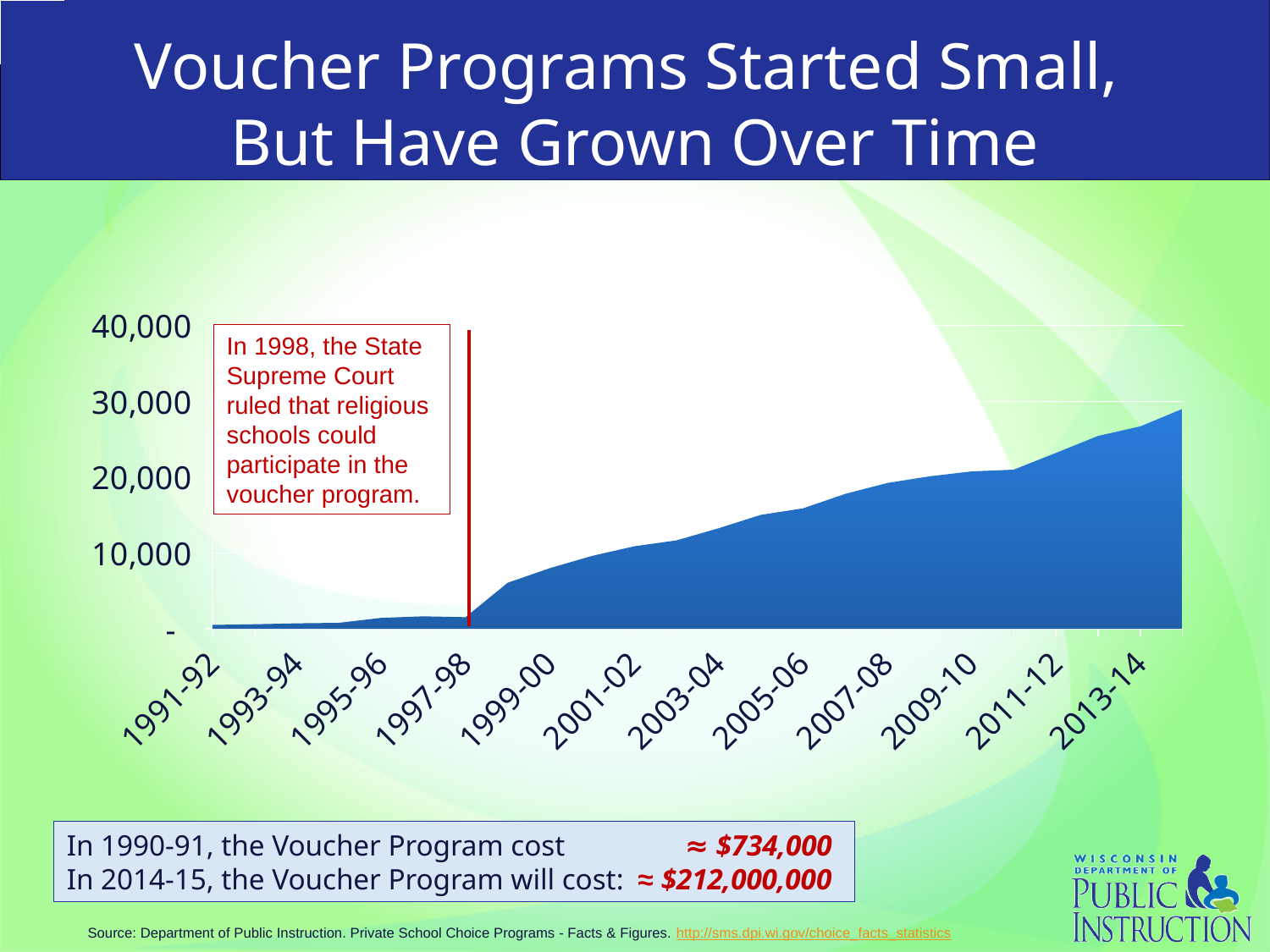
What kind of chart is shown on the slide? Area chart What is the title of the slide containing the chart? Voucher Programs Started Small, But Have Grown Over Time Is the value for 2007-08 greater or less than 10,000? greater Which has the larger value, 1997-98 or 2005-06? 2005-06 Do the values in the chart generally rise or fall from 1991-92 to 2013-14? Rise Is the value for 2013-14 greater or less than 20,000? greater Which labelled year on the x axis has the highest value? 2013-14 Which labelled year on the x axis has the lowest value? 1991-92 Is the value for 2013-14 greater or less than 30,000? less What is the highest value shown on the y axis? 40,000 How many year labels are shown on the x axis? 12